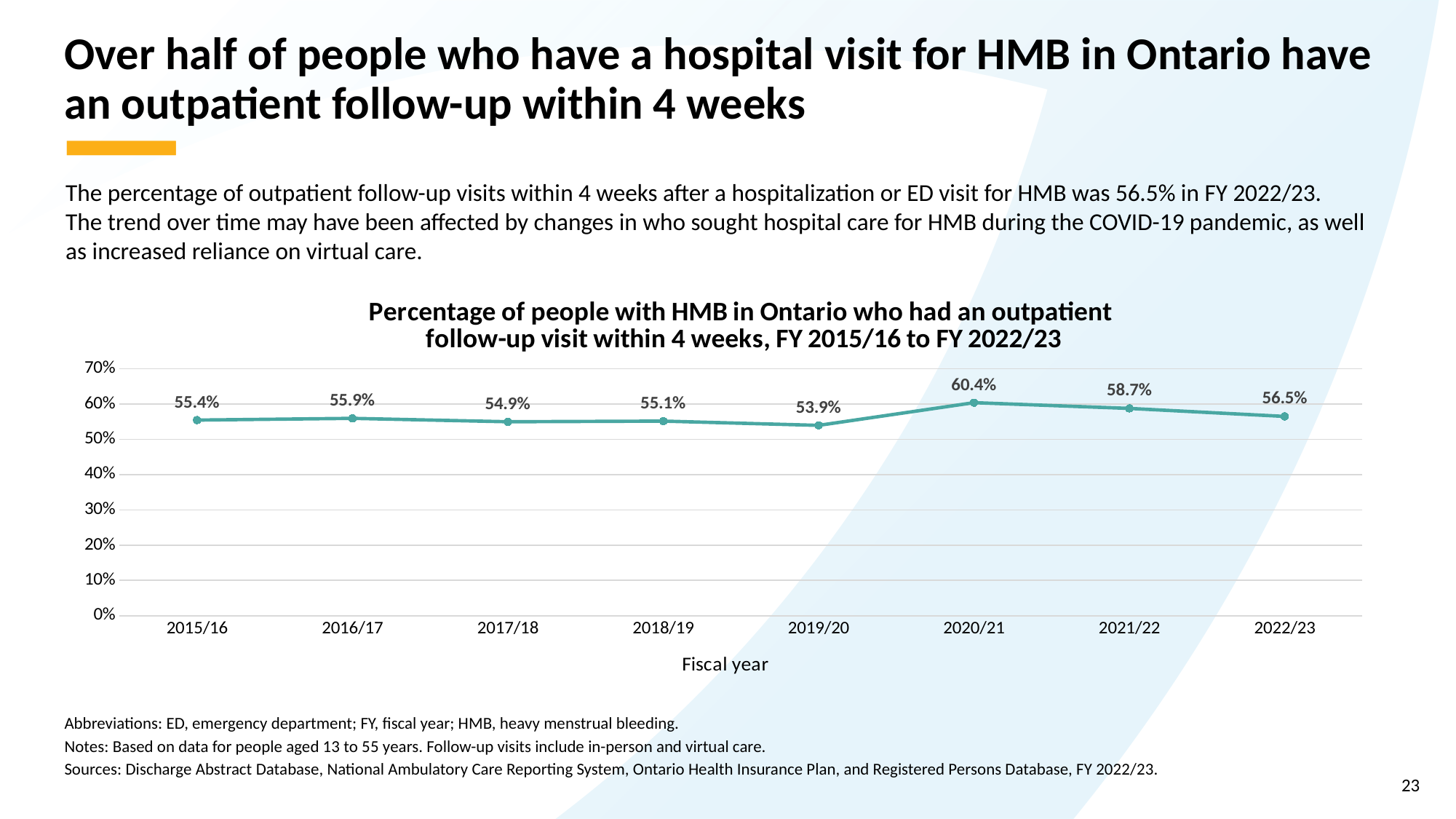
Which fiscal year has the lowest percentage of outpatient follow-up visits within 4 weeks? 2019/20 Which is larger, the value for FY 2020/21 or the value for FY 2015/16? 2020/21 What is the label of the x axis of the chart? Fiscal year What kind of chart is shown on the slide? Line chart What was the percentage of people with HMB who had an outpatient follow-up visit within 4 weeks in FY 2022/23? 56.5% What value is shown for FY 2016/17? 55.9% What value is shown for FY 2019/20? 53.9% How many fiscal years are plotted on the chart? 8 Which fiscal year has the highest percentage of outpatient follow-up visits within 4 weeks? 2020/21 What is the difference in percentage points between FY 2021/22 and FY 2022/23? 2.2 percentage points What is the difference in percentage points between FY 2020/21 and FY 2019/20? 6.5 percentage points Is the value for FY 2020/21 greater or less than 60%? greater